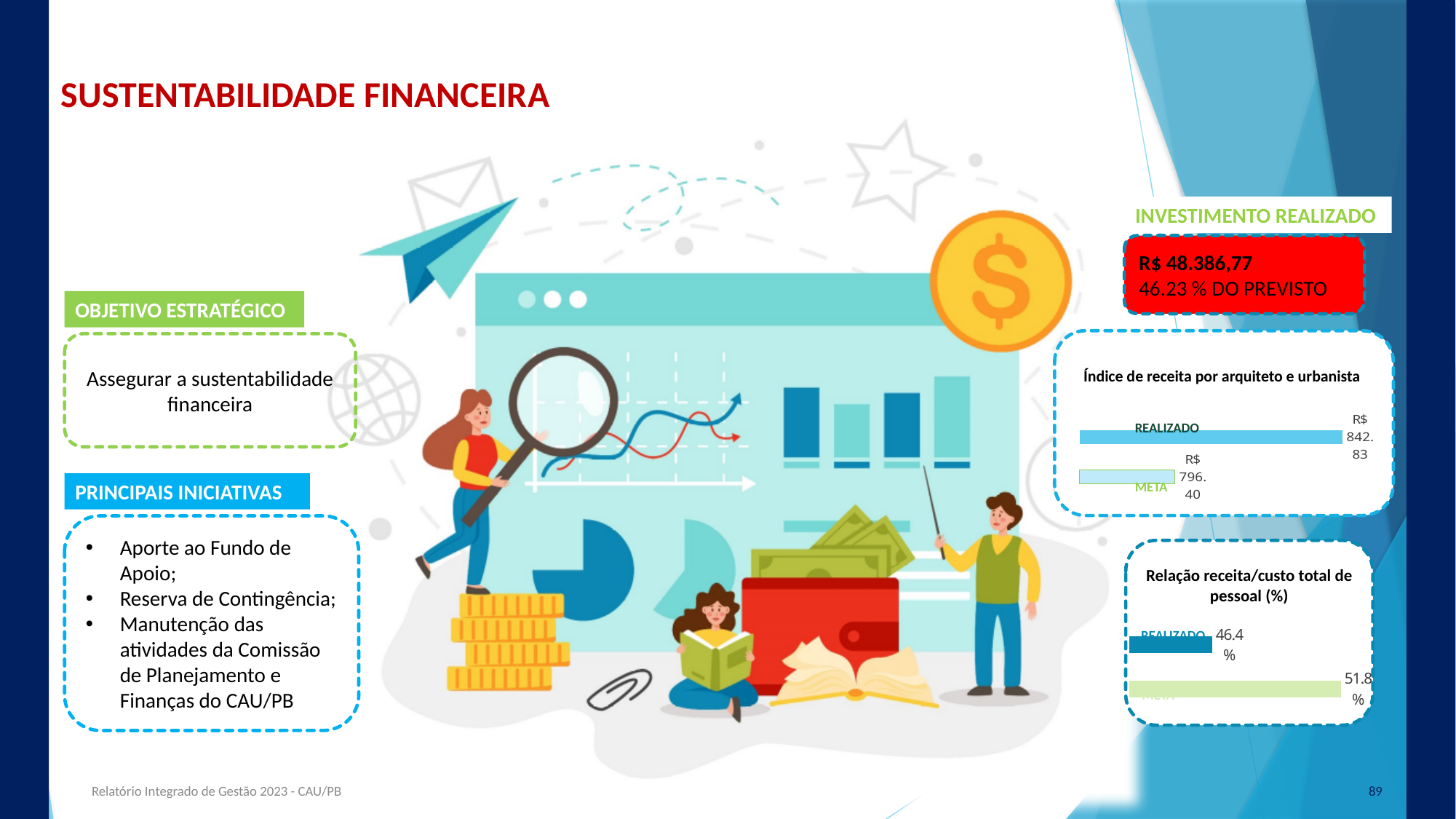
In the chart 'Relação receita/custo total de pessoal (%)', what is the difference between META and REALIZADO? 5.4% In the chart 'Índice de receita por arquiteto e urbanista', what is the value for REALIZADO? R$ 842.83 In the chart 'Relação receita/custo total de pessoal (%)', which category has the lower value? REALIZADO In the chart 'Índice de receita por arquiteto e urbanista', which category has the higher value? REALIZADO What kind of chart is 'Índice de receita por arquiteto e urbanista'? Bar chart In the chart 'Relação receita/custo total de pessoal (%)', is the value for META larger or smaller than the value for REALIZADO? Larger In the chart 'Índice de receita por arquiteto e urbanista', what is the difference between REALIZADO and META? R$ 46.43 In the chart 'Índice de receita por arquiteto e urbanista', what is the value for META? R$ 796.40 In the chart 'Relação receita/custo total de pessoal (%)', what is the value for META? 51.8% In the chart 'Índice de receita por arquiteto e urbanista', how many bars are plotted? 2 In the chart 'Relação receita/custo total de pessoal (%)', what is the value for REALIZADO? 46.4% What is the title of the lower chart on the right side of the slide? Relação receita/custo total de pessoal (%)